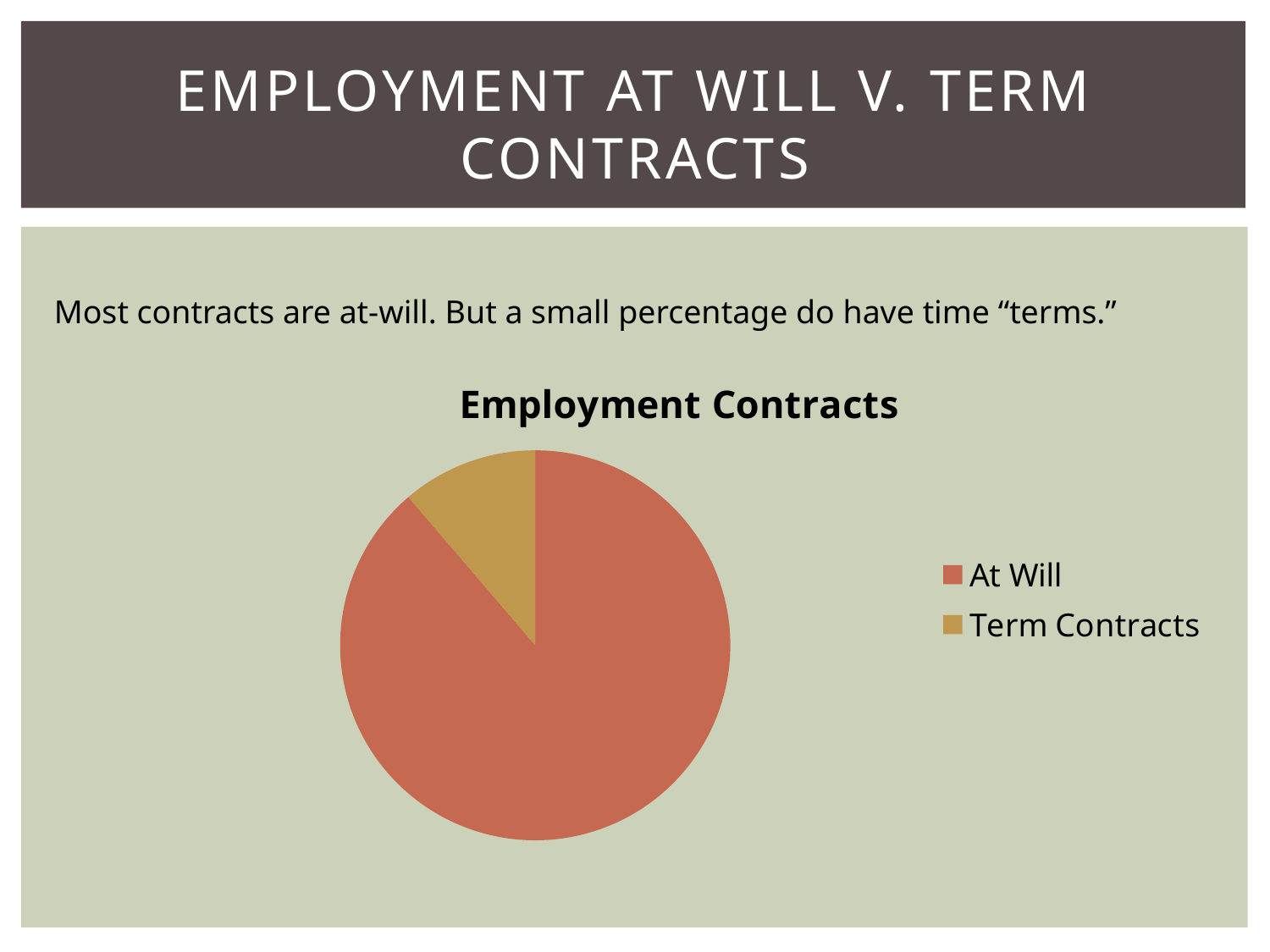
What kind of chart is shown on the slide? pie chart Which category has the largest slice of the pie? At Will How many entries does the legend list? 2 How many slices does the pie chart have? 2 What colour is the At Will slice? red Which category is shown in the gold/tan colour? Term Contracts Which category has the smallest slice of the pie? Term Contracts Which slice is larger, At Will or Term Contracts? At Will What is the title of the chart? Employment Contracts